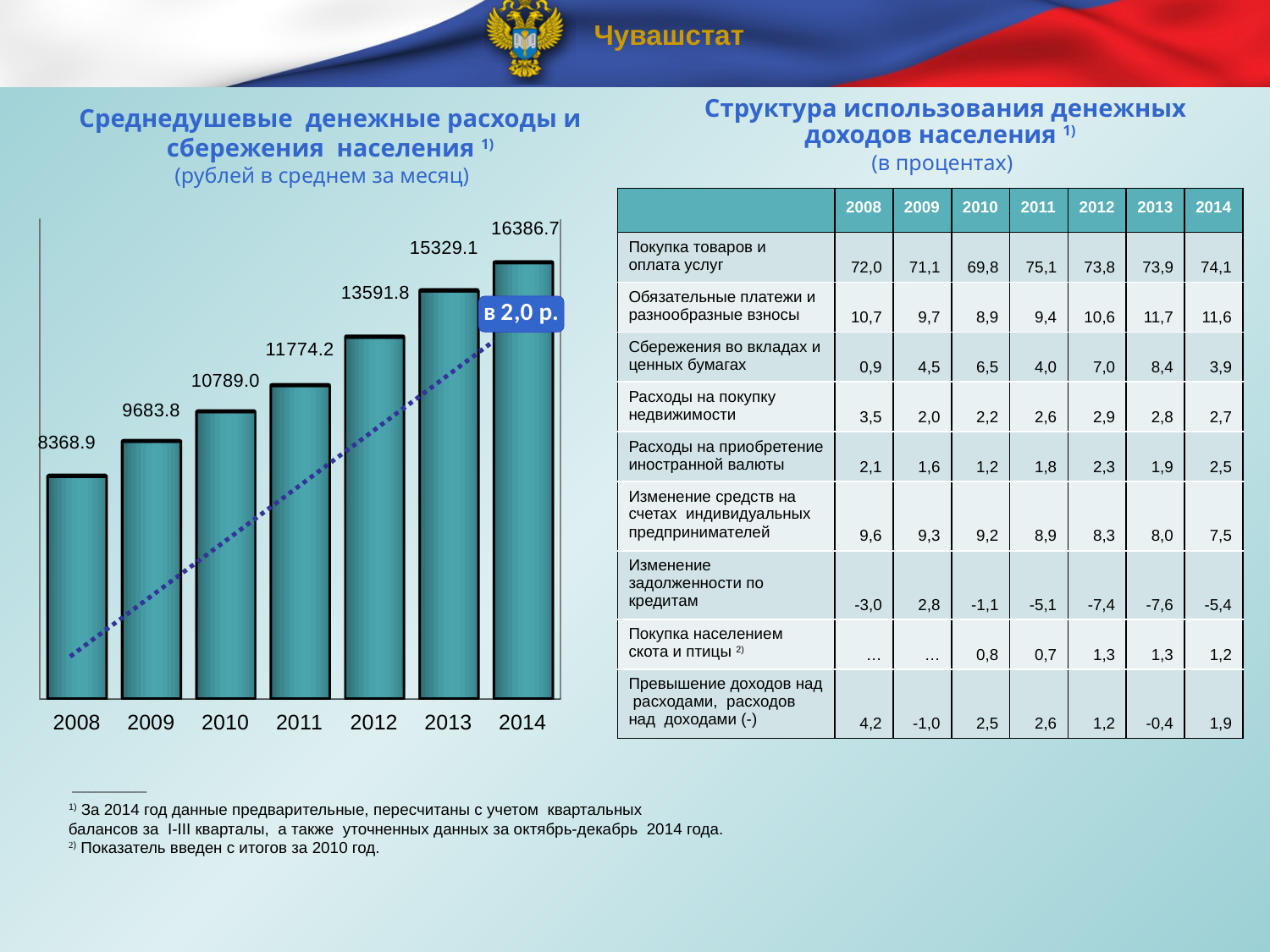
Do the values in the bar chart rise or fall from 2008 to 2014? rise What text is shown in the blue label next to the dotted trend line in the bar chart? в 2,0 р. What is the difference between the values for 2014 and 2008 in the bar chart? 8017.8 Which year has the lowest value in the bar chart? 2008 How many years are shown in the bar chart? 7 What is the difference between the values for 2013 and 2012 in the bar chart? 1737.3 What is the value for 2014 in the bar chart? 16386.7 What is the value for 2008 in the bar chart? 8368.9 Which is larger in the bar chart, the value for 2011 or the value for 2010? 2011 What is the value for 2012 in the bar chart? 13591.8 What kind of chart is shown on the left of the slide? bar chart Which year has the highest value in the bar chart? 2014